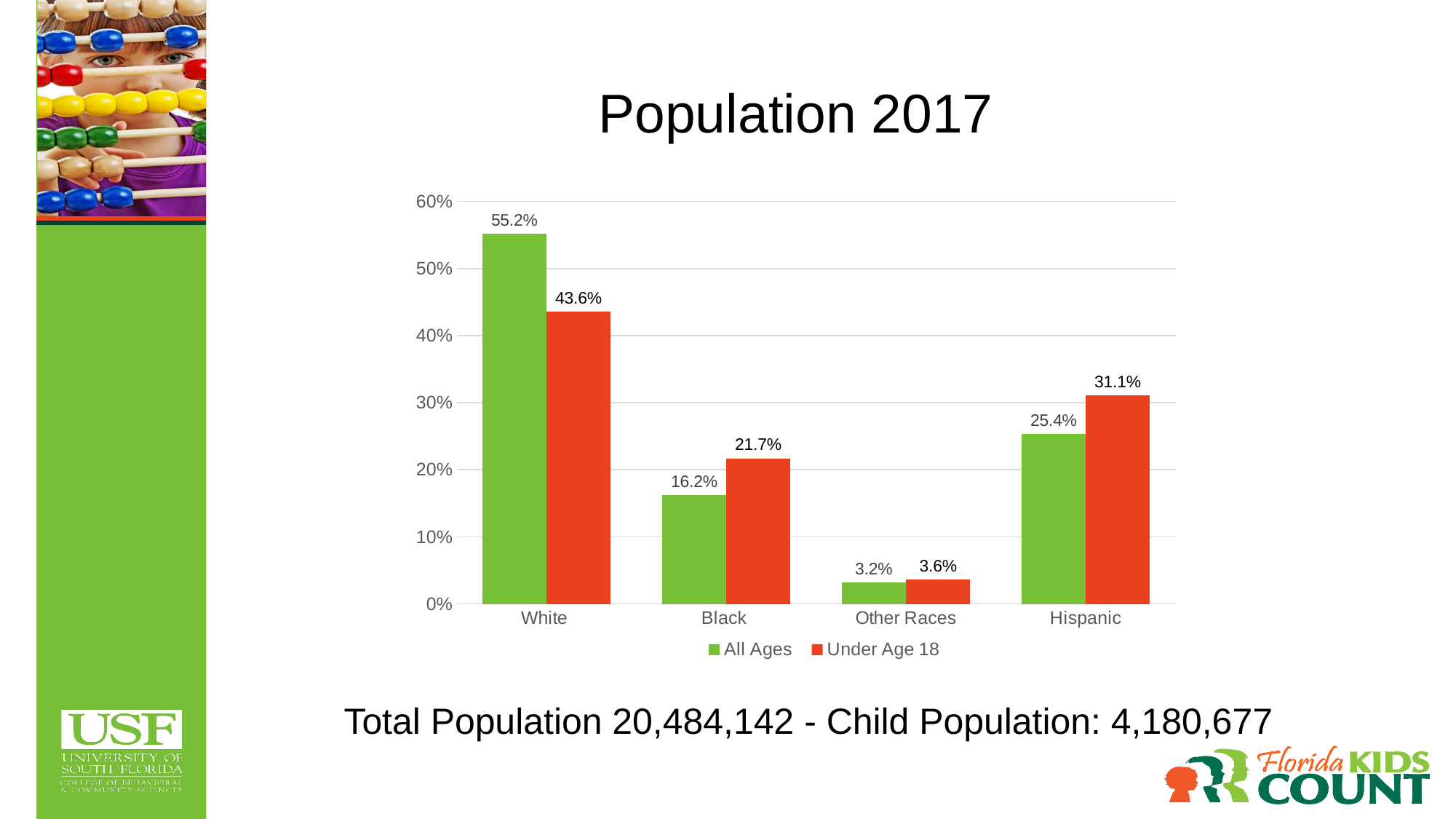
What kind of chart is shown on the slide? Bar chart What is the difference between the All Ages and Under Age 18 values for White? 11.6% What is the Under Age 18 value for Black? 21.7% How many series does the legend list? 2 What is the Under Age 18 value for Hispanic? 31.1% Which is larger for Black: the All Ages value or the Under Age 18 value? Under Age 18 Is the Under Age 18 value for White greater or less than 40%? greater What is the All Ages value for White? 55.2% Which category has the lowest Under Age 18 value? Other Races What is the difference between the Under Age 18 and All Ages values for Hispanic? 5.7% Which category has the highest All Ages value? White How many categories are shown on the x axis? 4